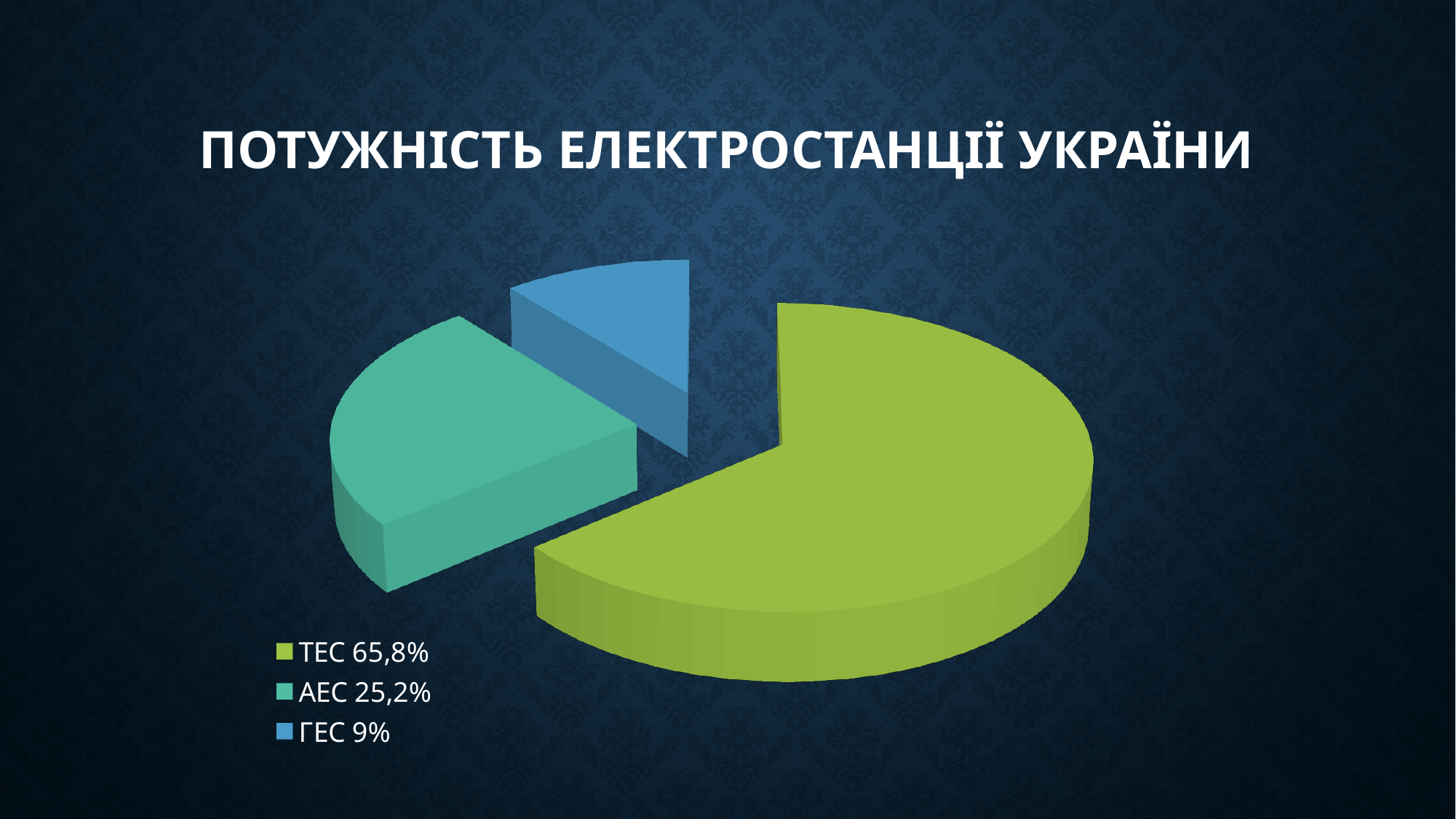
By how many percentage points does the share for АЕС exceed the share for ГЕС? 16,2 What is the title of the chart? ПОТУЖНІСТЬ ЕЛЕКТРОСТАНЦІЇ УКРАЇНИ What kind of chart is shown on the slide? pie chart What colour is the slice for ГЕС? blue What share of the pie does ГЕС account for? 9% By how many percentage points does the share for ТЕС exceed the share for АЕС? 40,6 Which category has the smallest slice of the pie? ГЕС What share of the pie does АЕС account for? 25,2% Which is larger, the share for АЕС or the share for ГЕС? АЕС What share of the pie does ТЕС account for? 65,8% How many slices does the pie chart have? 3 Which category has the largest slice of the pie? ТЕС